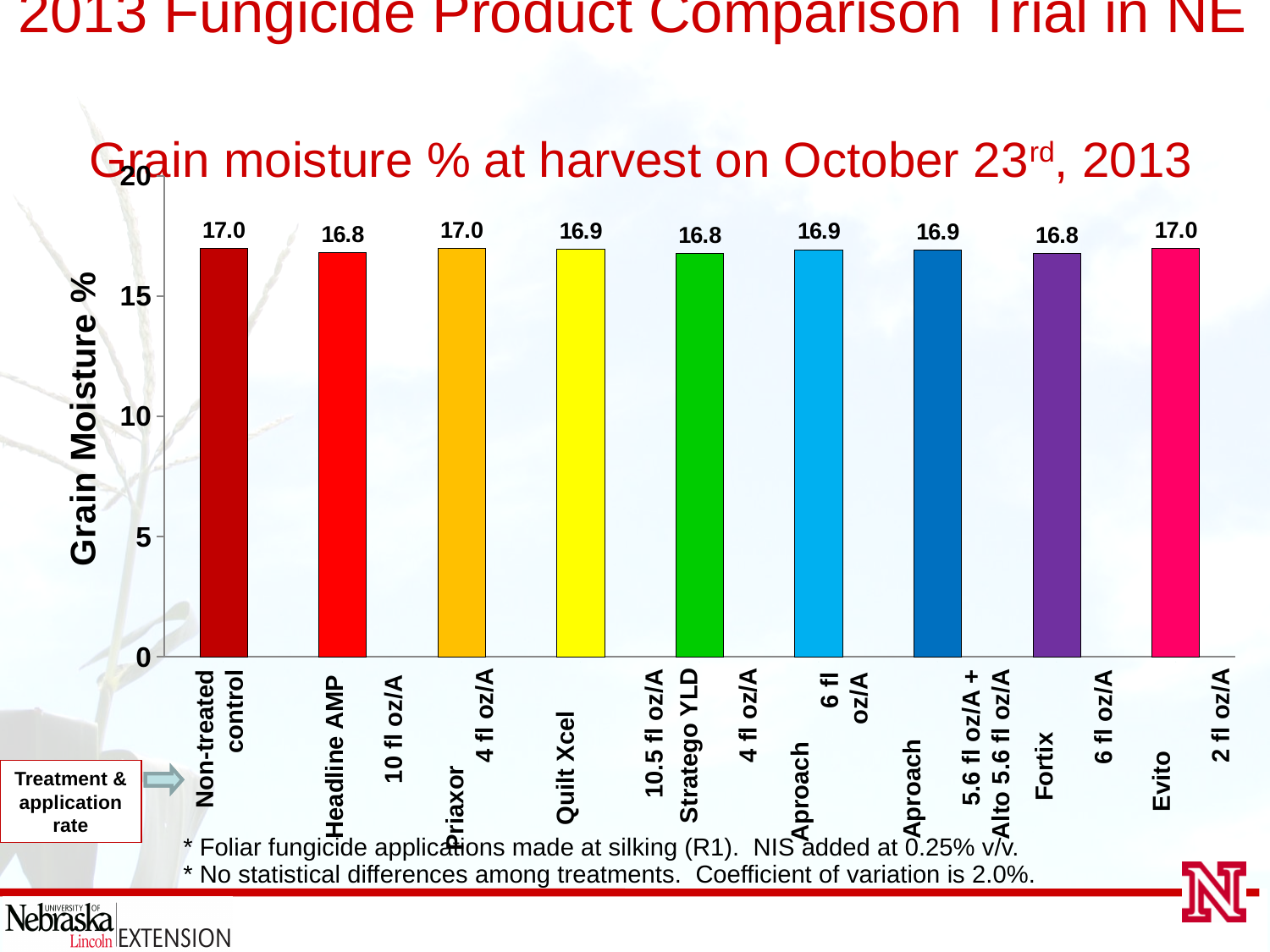
What is the grain moisture % for Fortix at 6 fl oz/A? 16.8 What is the grain moisture % for Evito at 2 fl oz/A? 17.0 Which has a higher grain moisture %, the Non-treated control or Headline AMP? Non-treated control What is the difference in grain moisture % between Priaxor and Stratego YLD? 0.2 What is the grain moisture % for Quilt Xcel at 10.5 fl oz/A? 16.9 What is the grain moisture % for the Non-treated control? 17.0 Is the grain moisture % for Aproach at 6 fl oz/A greater or less than 15? greater How many treatments are shown in the chart? 9 What is the label on the vertical axis of the chart? Grain Moisture % What is the maximum value shown on the vertical axis of the chart? 20 What type of chart is used to show grain moisture %? bar chart What is the grain moisture % for Headline AMP at 10 fl oz/A? 16.8